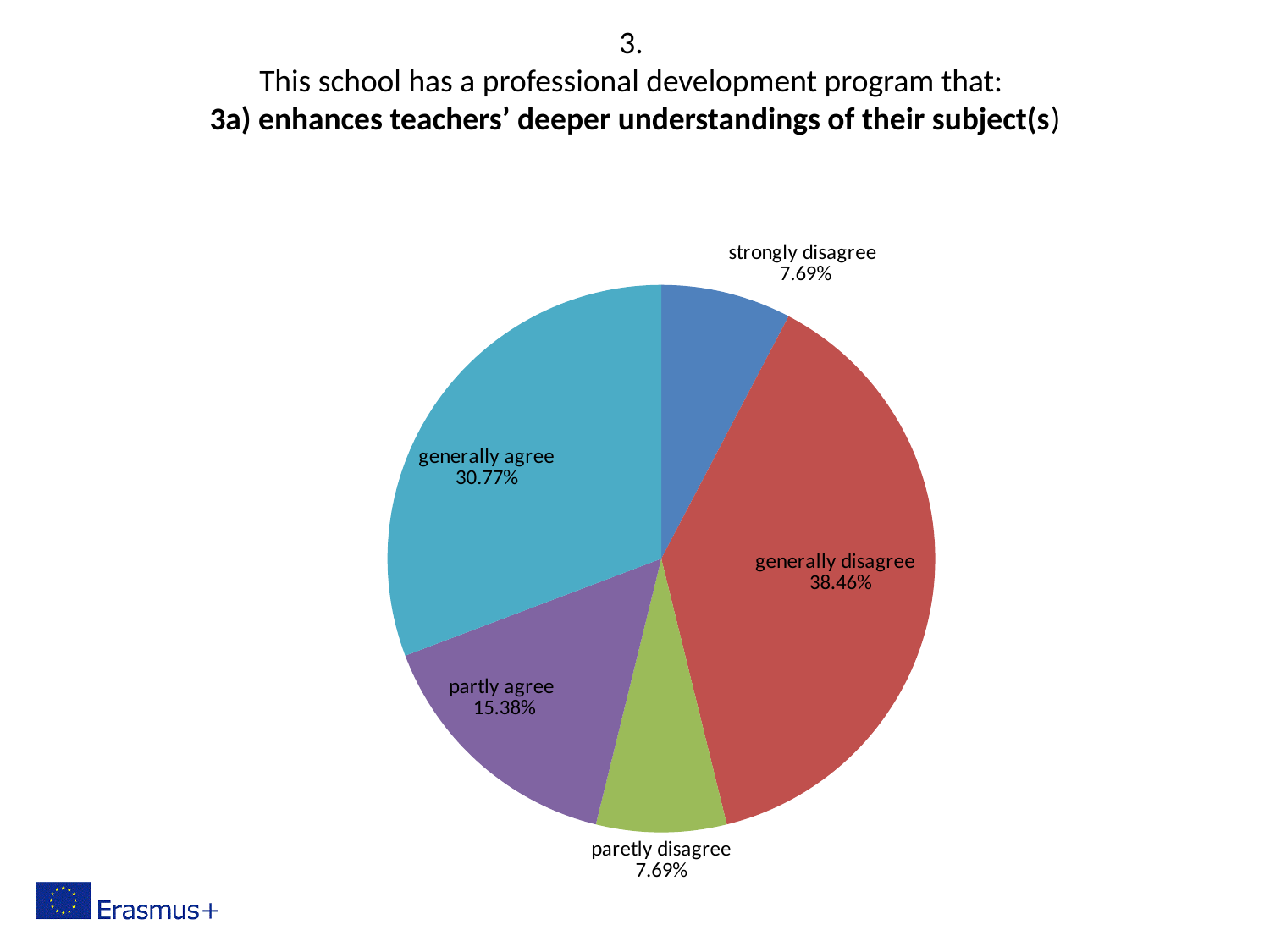
How many slices does the pie chart have? 5 Which is larger, the "partly agree" slice or the "paretly disagree" slice? partly agree What is the difference between the "generally disagree" and "generally agree" shares? 7.69% What share of the pie is labelled "partly agree"? 15.38% What kind of chart is shown on the slide? pie chart What share of the pie is labelled "strongly disagree"? 7.69% What colour is the "generally agree" slice? teal (light blue) What colour is the "generally disagree" slice? red What share of the pie is labelled "generally agree"? 30.77% What share of the pie is labelled "generally disagree"? 38.46% Which slice of the pie is the largest? generally disagree What is the combined share of the "generally agree" and "partly agree" slices? 46.15%